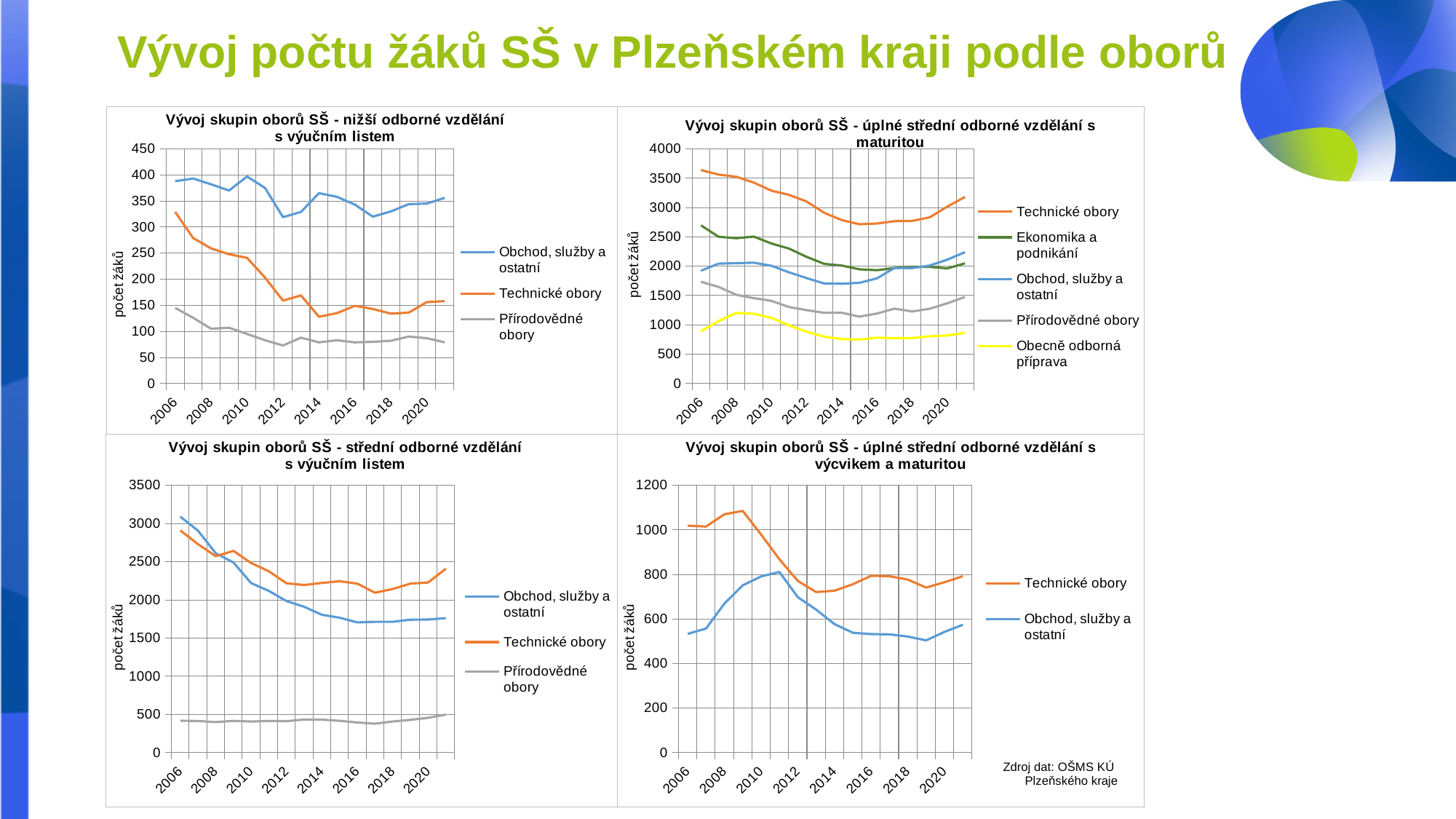
What kind of chart is the top-left chart titled "Vývoj skupin oborů SŠ - nižší odborné vzdělání s výučním listem"? line chart In the bottom-left chart (střední odborné vzdělání s výučním listem), does the Obchod, služby a ostatní series overall rise or fall from 2006 to 2021? fall In the bottom-right chart (úplné střední odborné vzdělání s výcvikem a maturitou), how many series does the legend list? 2 In the top-right chart (úplné střední odborné vzdělání s maturitou), is the value for Obecně odborná příprava in 2006 greater or less than 1000? less In the bottom-left chart (střední odborné vzdělání s výučním listem), is the value for Přírodovědné obory in 2006 greater or less than 500? less In the top-left chart (nižší odborné vzdělání s výučním listem), is the value for Technické obory in 2006 greater or less than 300? greater In the bottom-right chart (úplné střední odborné vzdělání s výcvikem a maturitou), which series has the larger value in 2006, Technické obory or Obchod, služby a ostatní? Technické obory In the bottom-left chart (střední odborné vzdělání s výučním listem), how many series does the legend list? 3 How many charts are shown on the slide? 4 In the top-right chart (úplné střední odborné vzdělání s maturitou), how many series does the legend list? 5